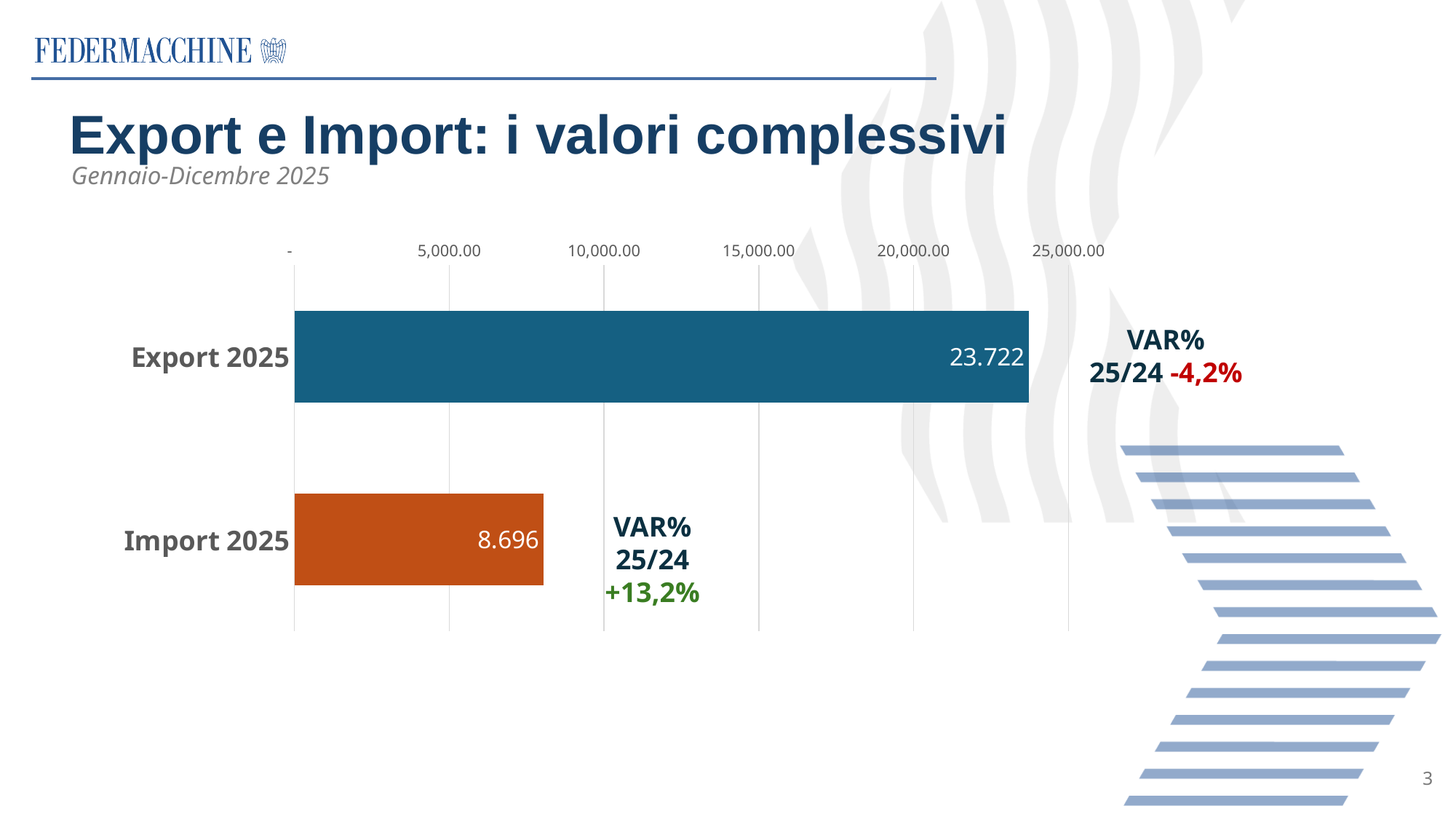
What is the VAR% 25/24 shown next to the Import 2025 bar? +13,2% What is the VAR% 25/24 shown next to the Export 2025 bar? -4,2% What is the difference between the Export 2025 value and the Import 2025 value? 15.026 What is the value shown for Import 2025? 8.696 Which category has the higher value, Export 2025 or Import 2025? Export 2025 What kind of chart is shown on the slide? Bar chart How many bars are plotted in the chart? 2 Is the value for Export 2025 greater or less than 20,000.00? greater What is the value shown for Export 2025? 23.722 Which category has the lowest value in the chart? Import 2025 Is the value for Import 2025 greater or less than 10,000.00? less What is the highest tick value shown on the horizontal axis? 25,000.00